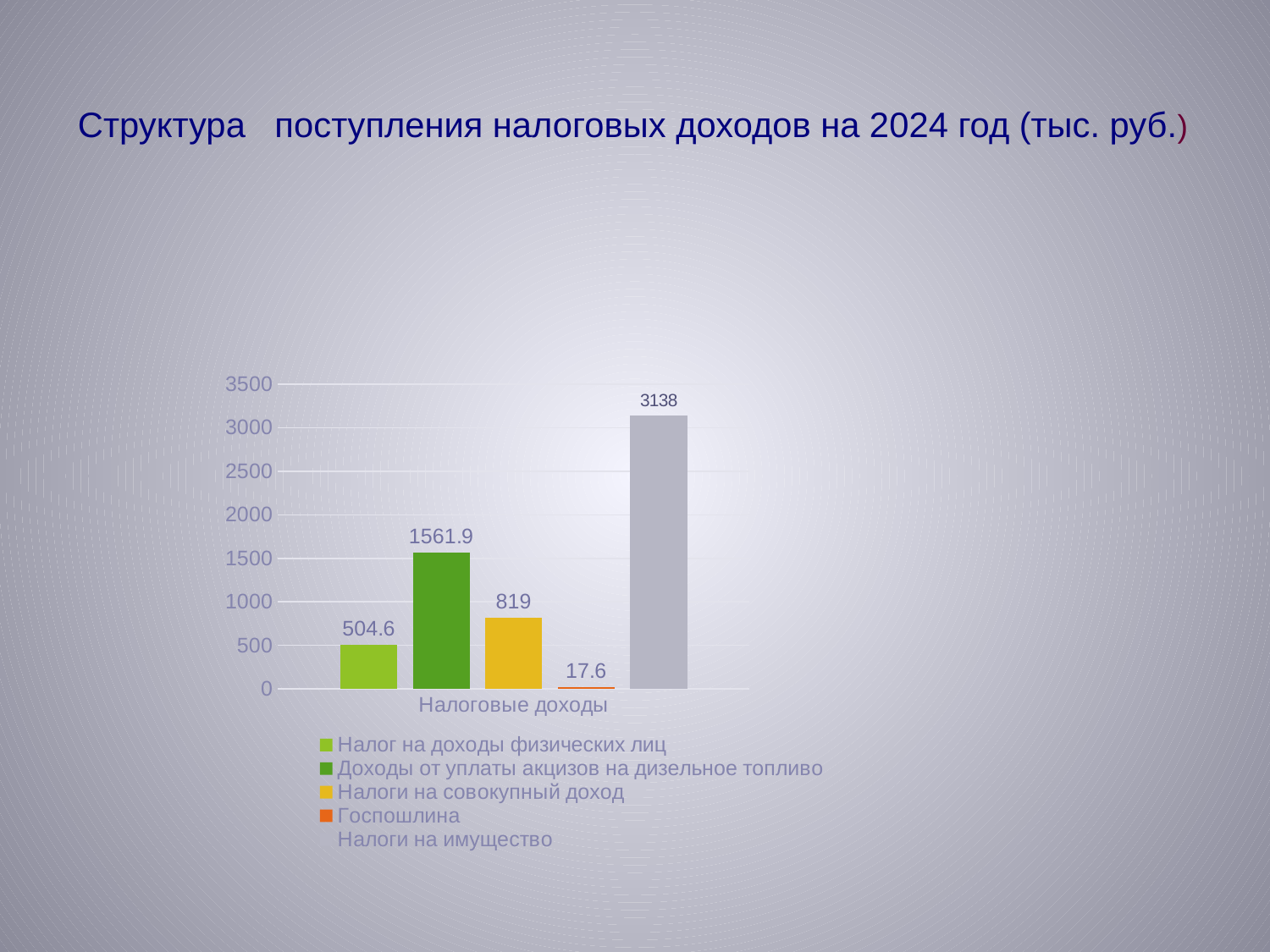
What is the value for Налоги на имущество? 3138 What is the value for Налоги на совокупный доход? 819 What is the value for Доходы от уплаты акцизов на дизельное топливо? 1561.9 What kind of chart is shown on the slide? Bar chart Which series has the lowest value? Госпошлина What is the title of the chart on the slide? Структура поступления налоговых доходов на 2024 год (тыс. руб.) Which is larger, Налоги на совокупный доход or Налог на доходы физических лиц? Налоги на совокупный доход What is the value for Налог на доходы физических лиц? 504.6 What is the value for Госпошлина? 17.6 Which series has the highest value? Налоги на имущество What is the difference between Налоги на имущество and Доходы от уплаты акцизов на дизельное топливо? 1576.1 How many series does the legend list? 5